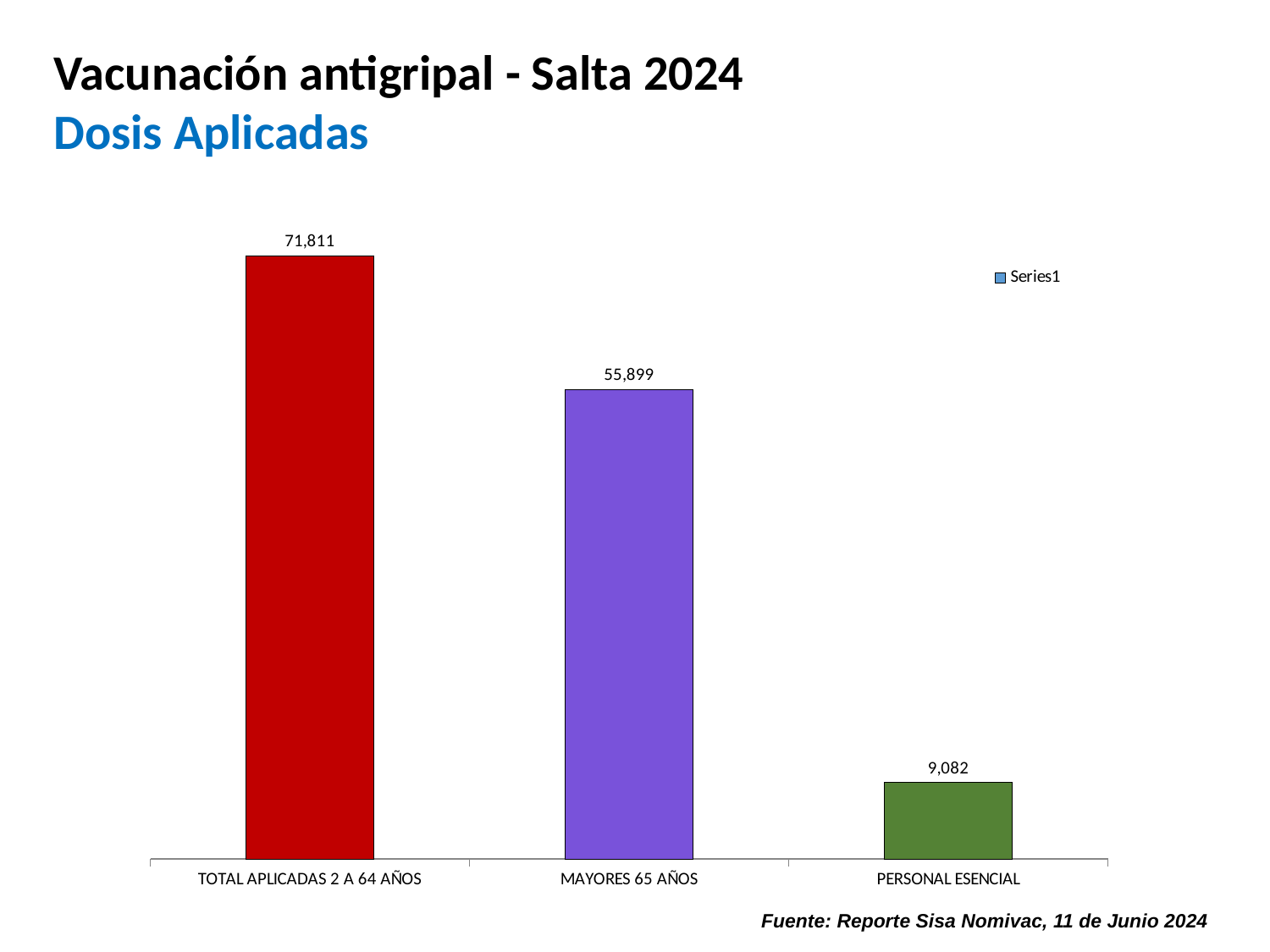
Which category has the lowest value? PERSONAL ESENCIAL What is the value for PERSONAL ESENCIAL? 9,082 Which category has the highest value? TOTAL APLICADAS 2 A 64 AÑOS What is the value for MAYORES 65 AÑOS? 55,899 What is the value for TOTAL APLICADAS 2 A 64 AÑOS? 71,811 What colour is the bar for PERSONAL ESENCIAL? Green How many series does the legend list? 1 What is the difference between the values for MAYORES 65 AÑOS and PERSONAL ESENCIAL? 46,817 How many categories are shown on the x axis? 3 Which is larger, the value for MAYORES 65 AÑOS or the value for PERSONAL ESENCIAL? MAYORES 65 AÑOS What is the difference between the values for TOTAL APLICADAS 2 A 64 AÑOS and MAYORES 65 AÑOS? 15,912 What kind of chart is shown on the slide? Bar chart